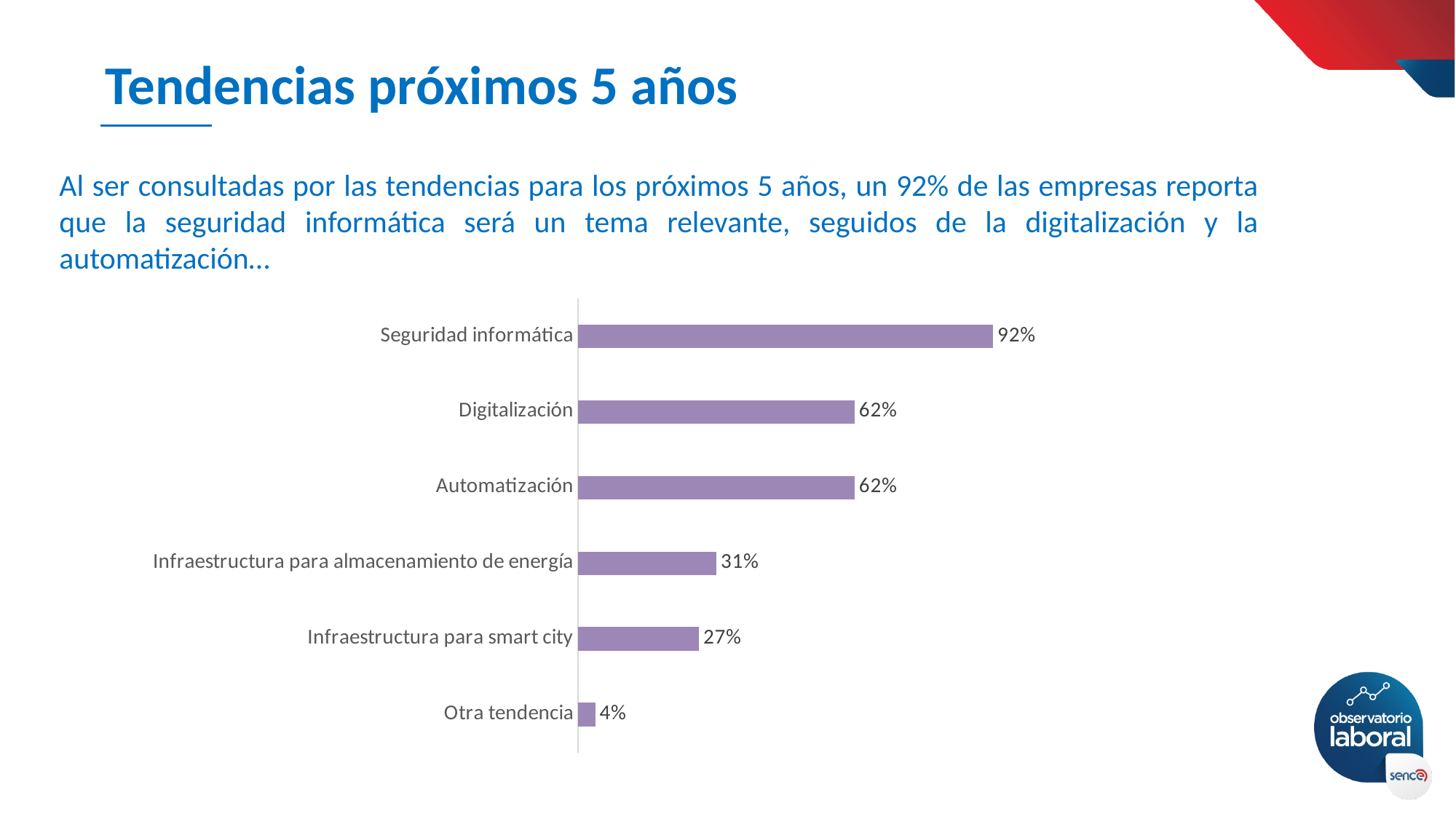
What is the value for Digitalización? 62% What is the difference between the values for Seguridad informática and Digitalización? 30% What is the value for Otra tendencia? 4% Which is larger, the value for Automatización or the value for Infraestructura para smart city? Automatización What is the value for Infraestructura para smart city? 27% What kind of chart is shown on the slide? Bar chart Which category has the lowest value? Otra tendencia What is the value for Infraestructura para almacenamiento de energía? 31% How many categories are shown in the chart? 6 What is the difference between the values for Infraestructura para almacenamiento de energía and Infraestructura para smart city? 4% What is the value for Seguridad informática? 92% Which category has the highest value? Seguridad informática